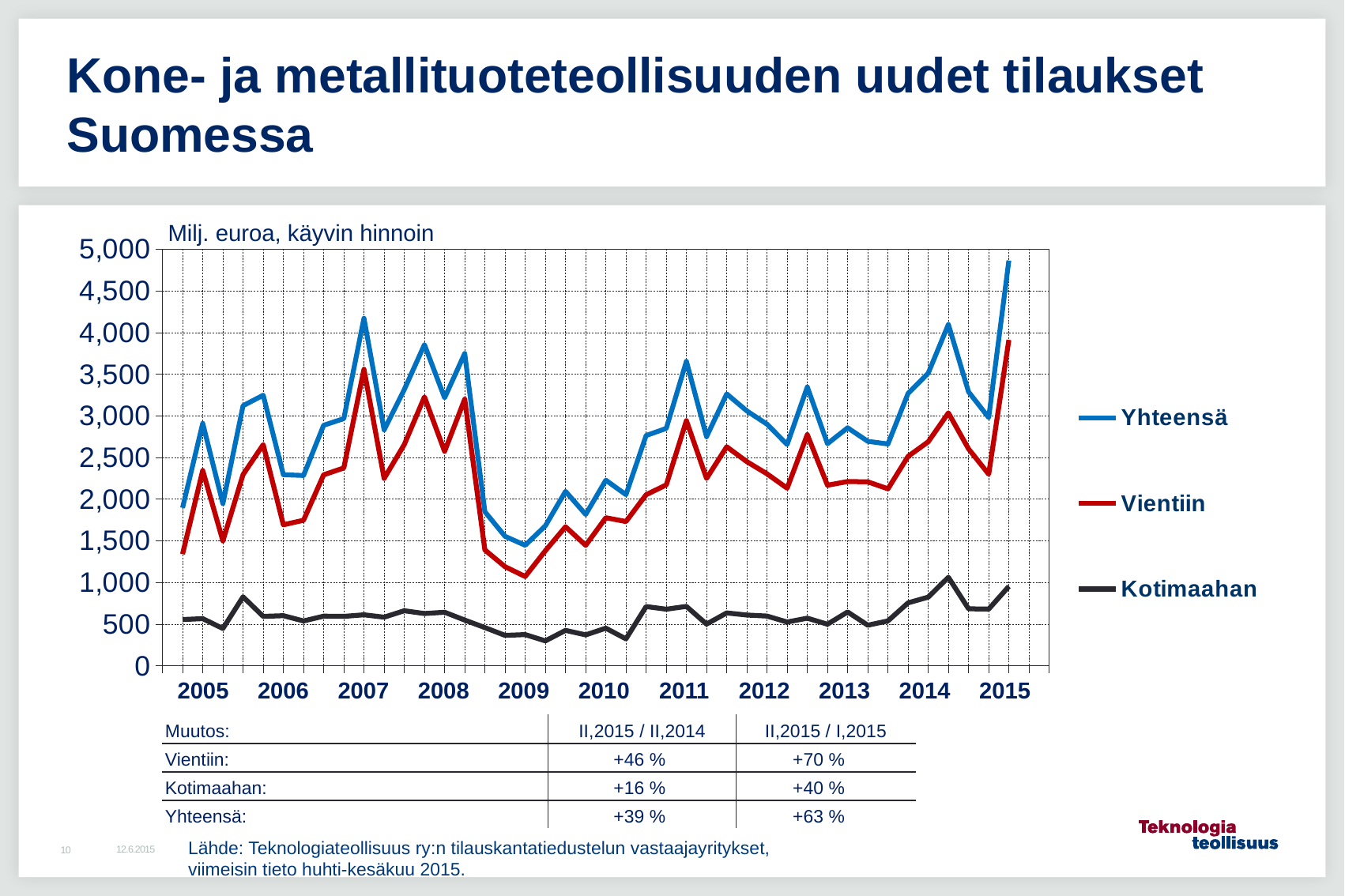
How many series does the legend list? 3 Which is larger at the last point in 2015, Vientiin or Kotimaahan? Vientiin What kind of chart is shown on the slide? line chart Does the Yhteensä line rise or fall from 2008 to 2009? fall How many years are labelled on the x axis? 11 Is the value for Vientiin at the last point in 2015 greater or less than 3,500? greater Is the value for Kotimaahan in 2009 greater or less than 500? less Is the value for Yhteensä at the last point in 2015 greater or less than 4,500? greater Which series is shown in red in the legend? Vientiin Which series has the highest values throughout the whole period? Yhteensä What unit label is printed above the chart? Milj. euroa, käyvin hinnoin Which series has the lowest values throughout the whole period? Kotimaahan